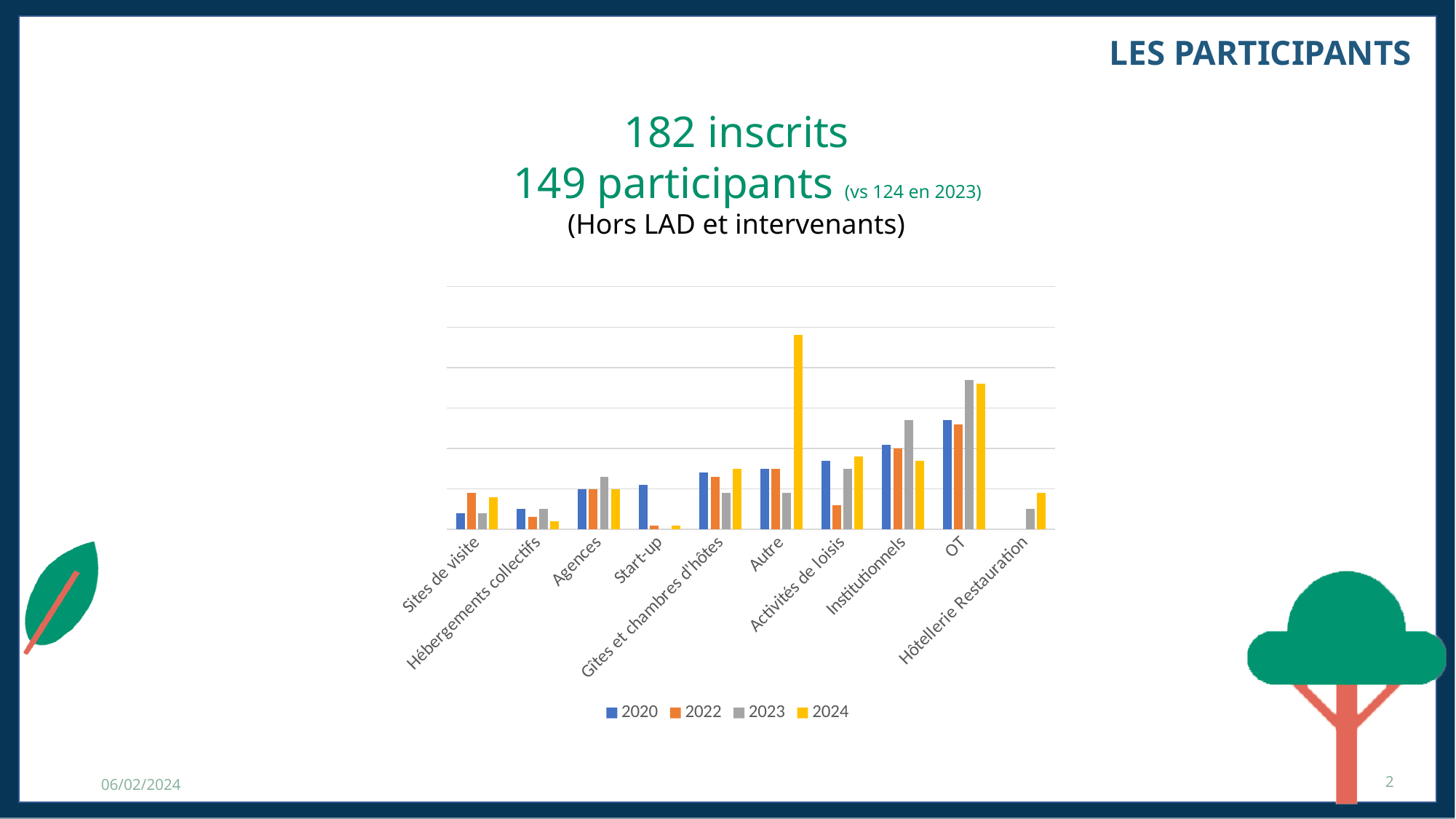
For the 2024 series, which is larger: Autre or OT? Autre Which category has the highest bar for the 2024 series? Autre Which series are listed in the chart's legend? 2020, 2022, 2023, 2024 Which category has the highest bar for the 2020 series? OT Which category has the highest bar for the 2023 series? OT What kind of chart is shown on the slide? Bar chart How many series does the chart's legend list? 4 For Start-up, which series has the larger bar: 2020 or 2024? 2020 For Institutionnels, which series has the larger bar: 2022 or 2023? 2023 What colour represents the 2024 series in the chart? Yellow Which category has the lowest bar for the 2024 series? Start-up How many categories are shown on the x axis of the chart? 10